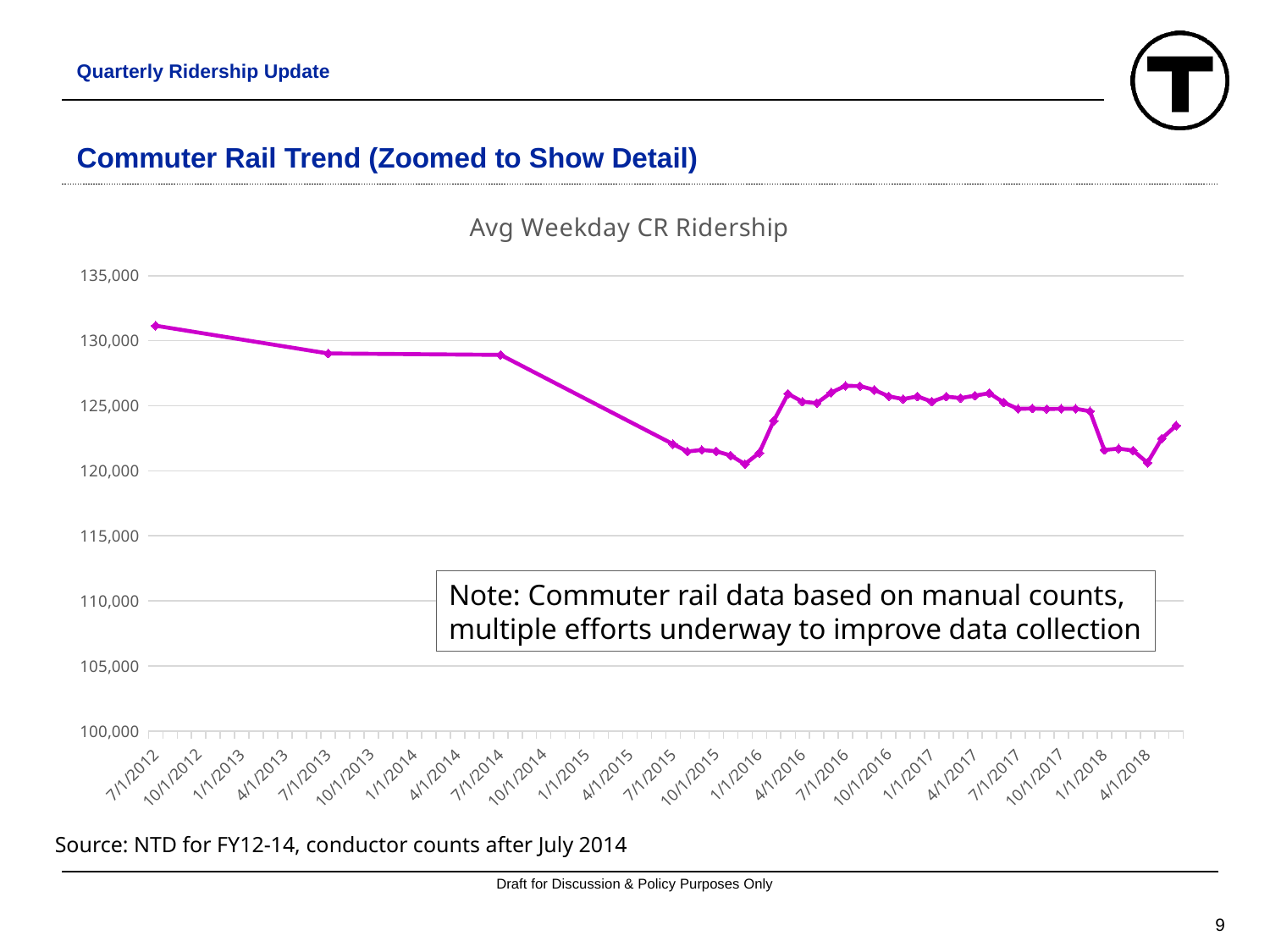
Is the value for 7/1/2016 greater or less than 125,000? greater Which is larger, the value for 7/1/2012 or the value for 4/1/2018? 7/1/2012 Is the value for 4/1/2018 greater or less than 125,000? less Does Avg Weekday CR Ridership rise or fall between 7/1/2012 and 7/1/2015? Fall What kind of chart is shown on the slide? Line chart Is the value for 7/1/2014 greater or less than 125,000? greater What is the title of the chart? Avg Weekday CR Ridership How many data series are plotted in the chart? 1 What is the highest value shown on the vertical axis? 135,000 Which date has the highest Avg Weekday CR Ridership? 7/1/2012